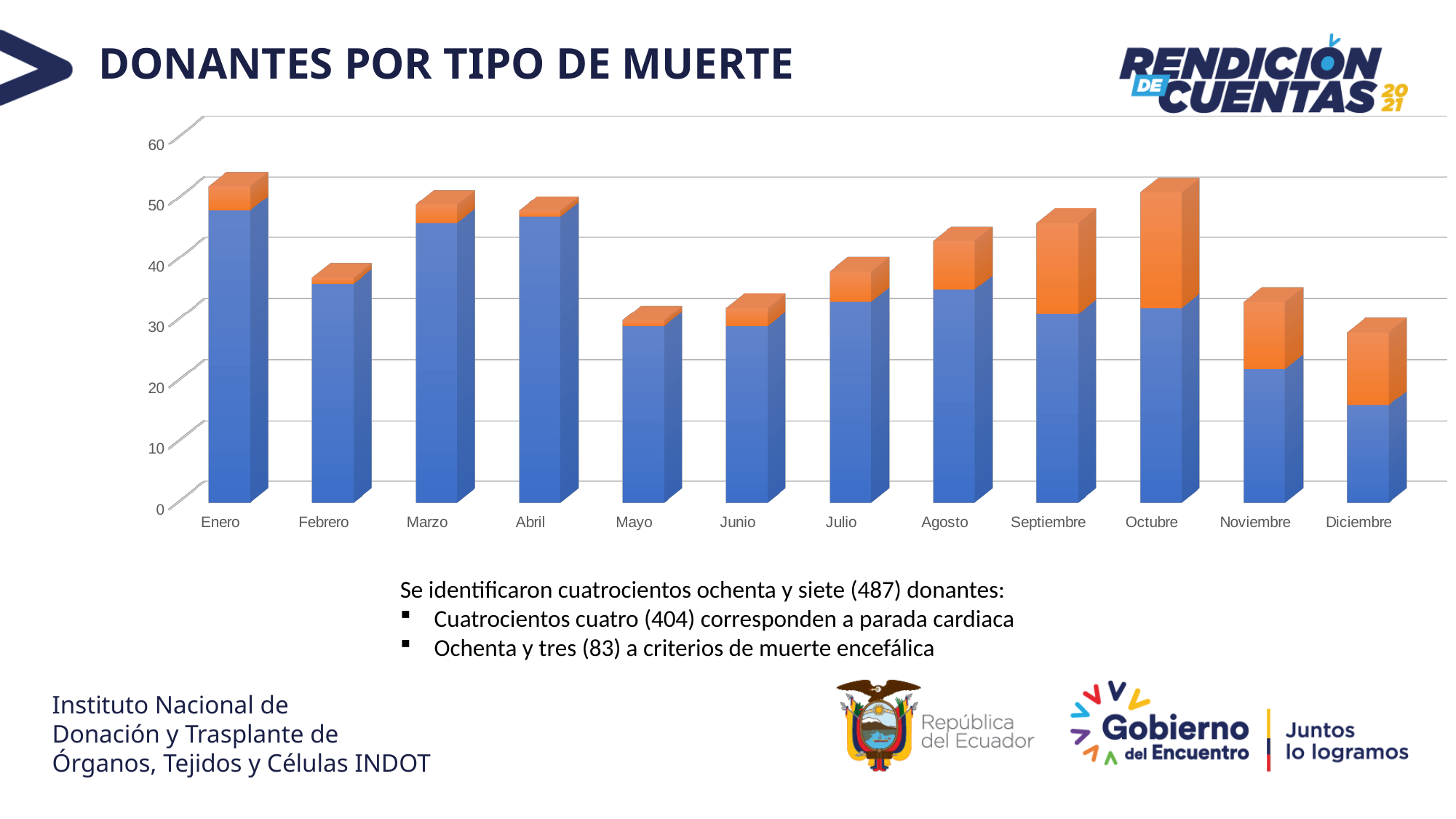
Is the total bar height for Septiembre greater or less than 40? greater Is the blue segment for Diciembre greater or less than 20? less Which has the taller total bar, Mayo or Agosto? Agosto Which has the taller total bar, Febrero or Marzo? Marzo How many months are shown on the x axis of the chart? 12 What kind of chart is shown on the slide? bar chart Which month has the tallest blue segment? Enero Which month has the largest orange segment? Octubre What is the title of the chart on the slide? DONANTES POR TIPO DE MUERTE Which month has the shortest blue segment? Diciembre Is the total bar height for Febrero greater or less than 40? less